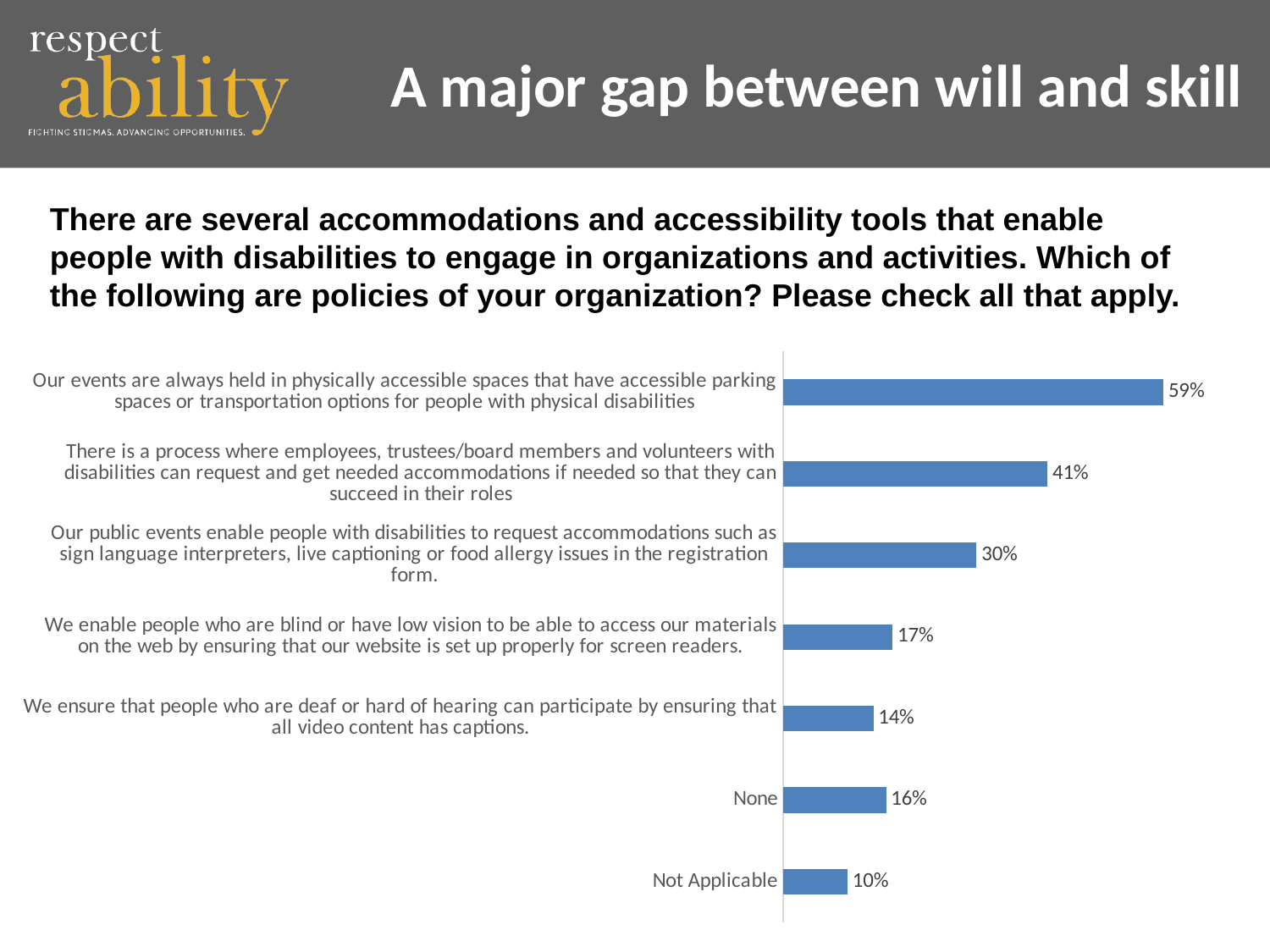
How many categories are shown in the chart? 7 Which category has the highest value in the chart? Our events are always held in physically accessible spaces that have accessible parking spaces or transportation options for people with physical disabilities What percentage of organizations say their events are always held in physically accessible spaces? 59% What is the value for the 'Not Applicable' category? 10% What is the difference between the value for accessible event spaces (59%) and the value for the accommodation request process (41%)? 18% What kind of chart is shown on the slide? Bar chart What is the value for the 'None' category? 16% Which category has the lowest value in the chart? Not Applicable What percentage of organizations ensure that all video content has captions? 14% Which is larger: the value for 'None' or the value for ensuring video content has captions? None What is the title of the slide? A major gap between will and skill What percentage of organizations have a process where employees, trustees/board members and volunteers with disabilities can request accommodations? 41%